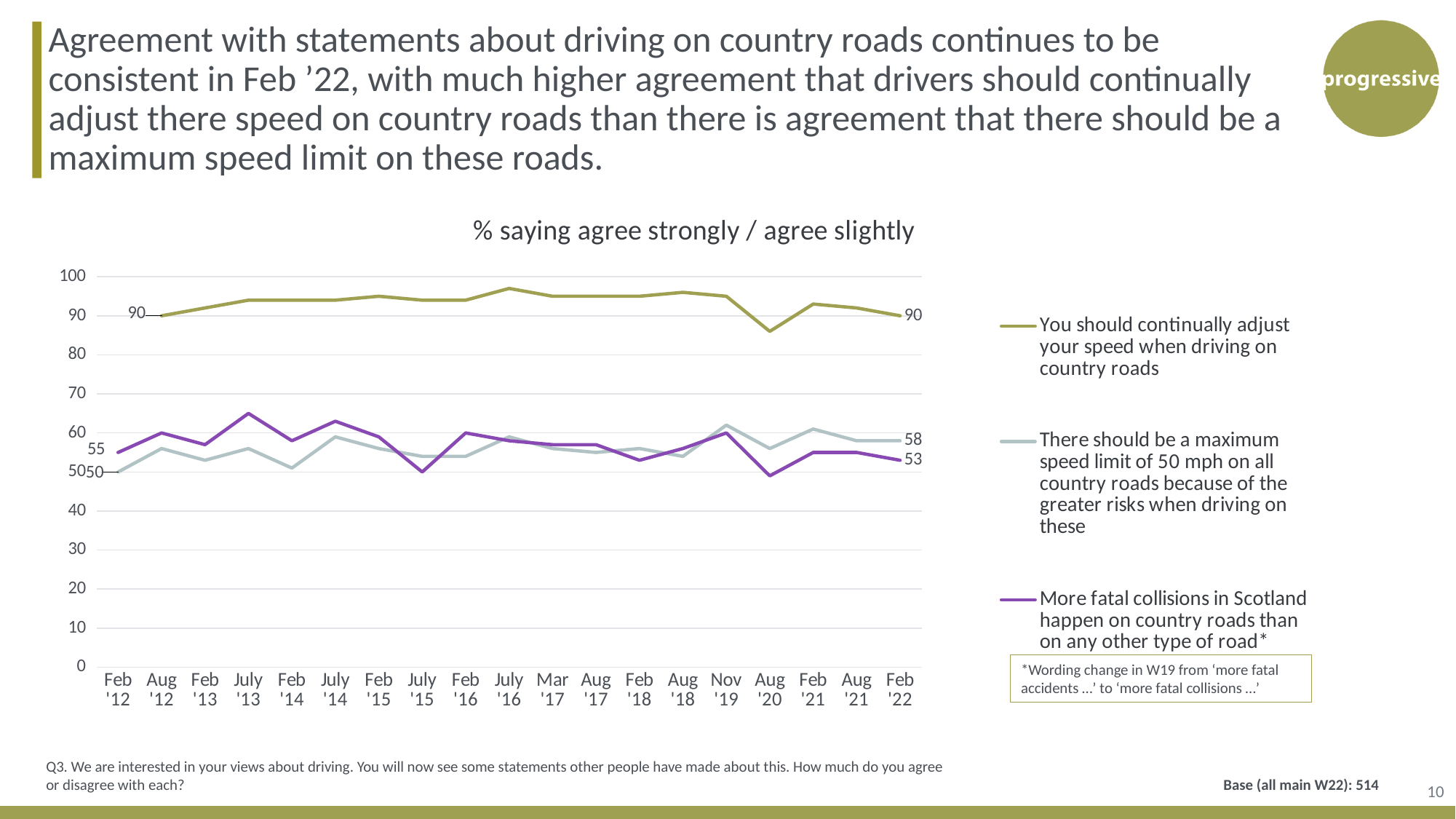
What kind of chart is shown on the slide? Line chart What is the value for 'There should be a maximum speed limit of 50 mph on all country roads' in Feb '12? 50 What is the value for 'You should continually adjust your speed when driving on country roads' in Feb '22? 90 What is the value for 'There should be a maximum speed limit of 50 mph on all country roads' in Feb '22? 58 What is the value for 'More fatal collisions in Scotland happen on country roads than on any other type of road' in Feb '22? 53 What is the value for 'More fatal collisions in Scotland happen on country roads than on any other type of road' in Feb '12? 55 What is the title of the chart? % saying agree strongly / agree slightly How many series does the legend list? 3 How many time points are shown on the x axis? 19 In Feb '22, what is the difference between the value for the maximum speed limit statement and the value for the fatal collisions statement? 5 In Feb '12, which is larger: the value for the fatal collisions statement or the value for the maximum speed limit statement? More fatal collisions in Scotland happen on country roads than on any other type of road Is the value for 'You should continually adjust your speed when driving on country roads' in Aug '20 greater or less than 90? less